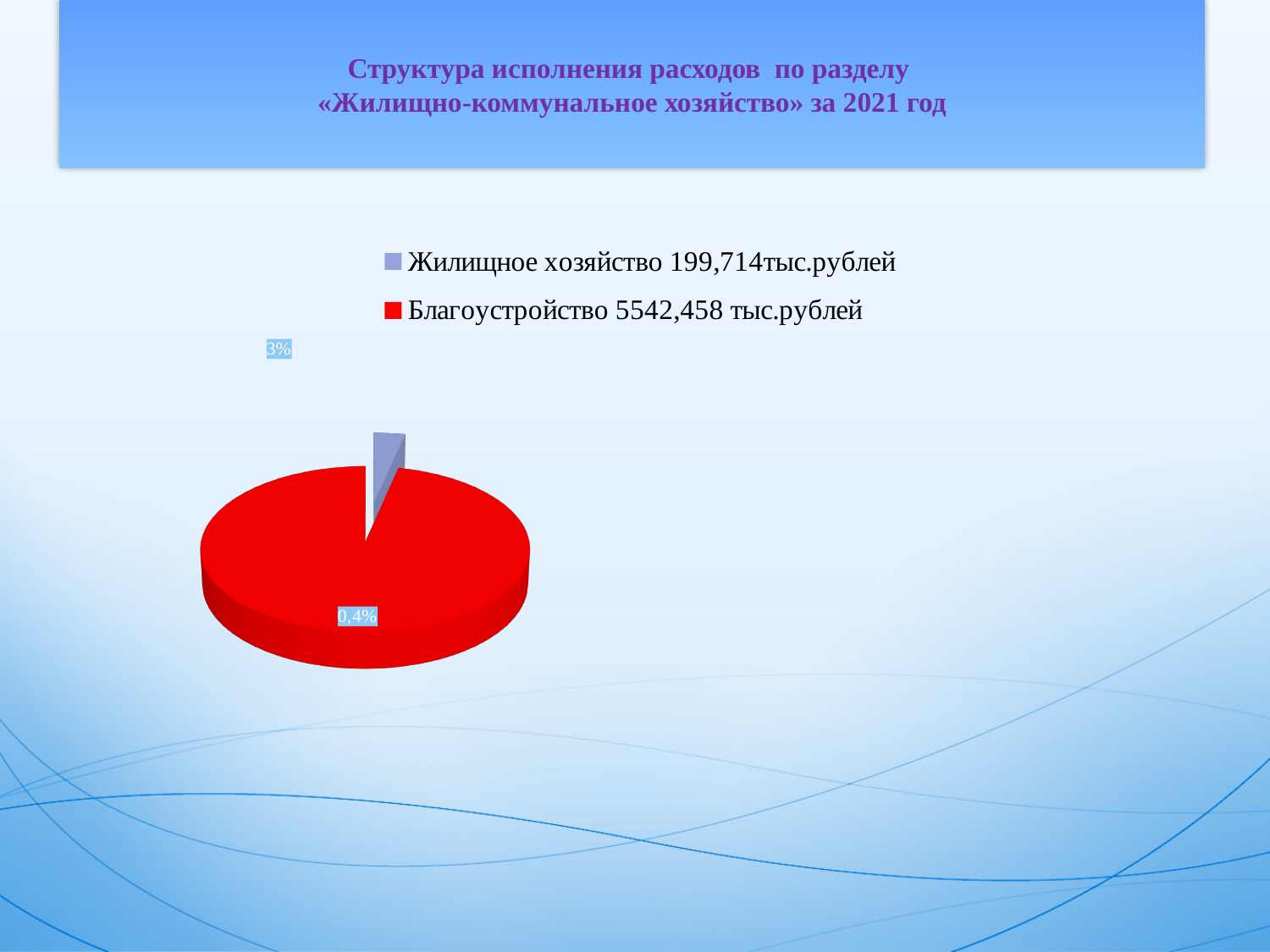
Which category has the largest slice of the pie chart? Благоустройство Which year does the chart title say the data is for? 2021 How many slices does the pie chart have? 2 What colour is the Благоустройство slice in the pie chart? red According to the legend, what is the value for Благоустройство? 5542,458 тыс.рублей According to the legend, what is the value for Жилищное хозяйство? 199,714 тыс.рублей Which is larger, Жилищное хозяйство or Благоустройство? Благоустройство What kind of chart is shown on the slide? pie chart Which category has the smallest slice of the pie chart? Жилищное хозяйство How many entries does the legend of the pie chart list? 2